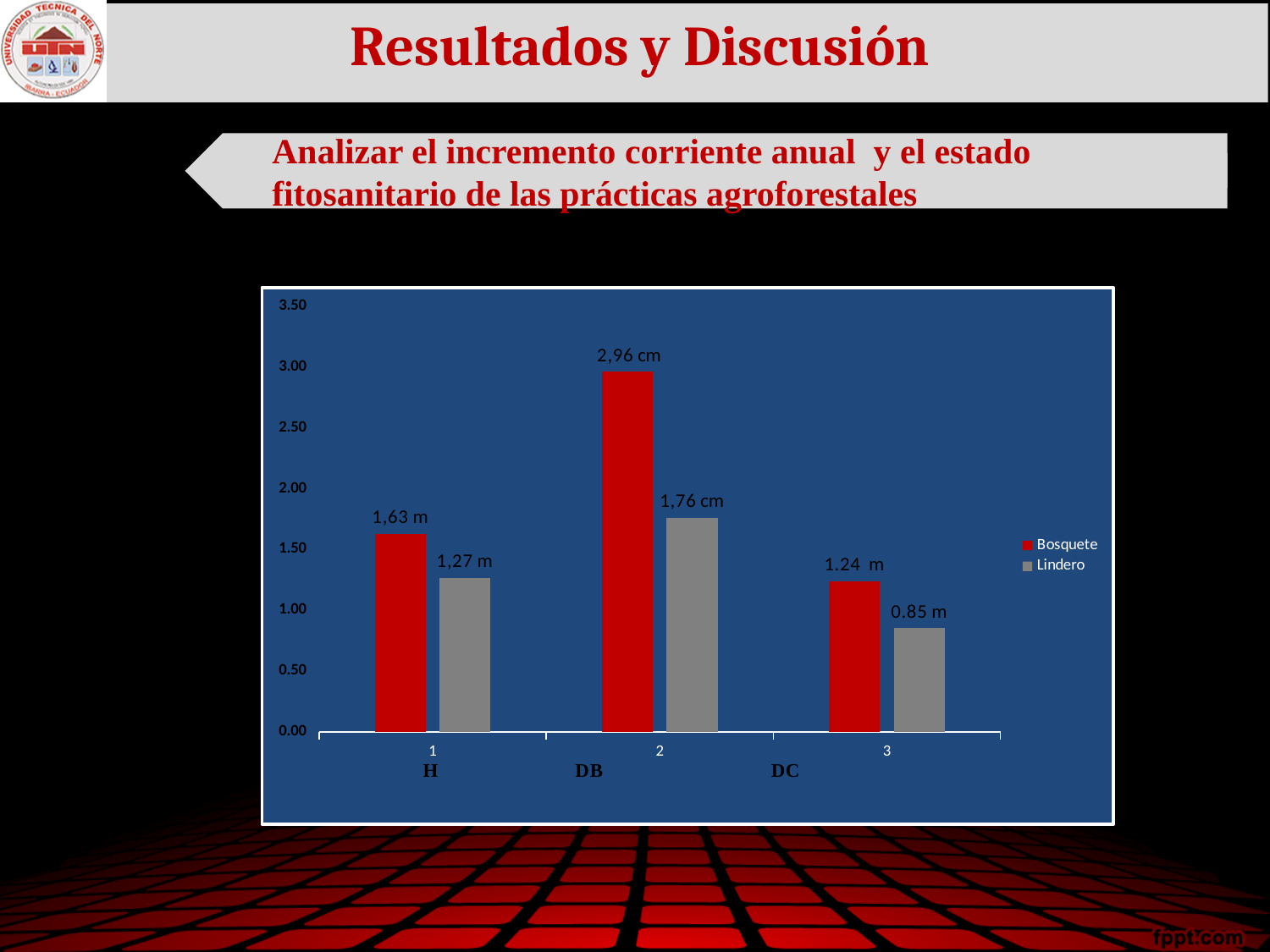
What is the value for Bosquete in category DB? 2,96 cm What kind of chart is shown on the slide? bar chart In category DC, which series has the larger value, Bosquete or Lindero? Bosquete What is the difference between the Bosquete and Lindero values in category DC? 0.39 m What is the value for Bosquete in category H? 1,63 m Which category has the highest Bosquete value? DB How many series does the legend list? 2 What is the value for Lindero in category H? 1,27 m What is the value for Lindero in category DC? 0.85 m How many categories are shown on the x axis? 3 Which category has the lowest Lindero value? DC What are the two series named in the legend? Bosquete and Lindero